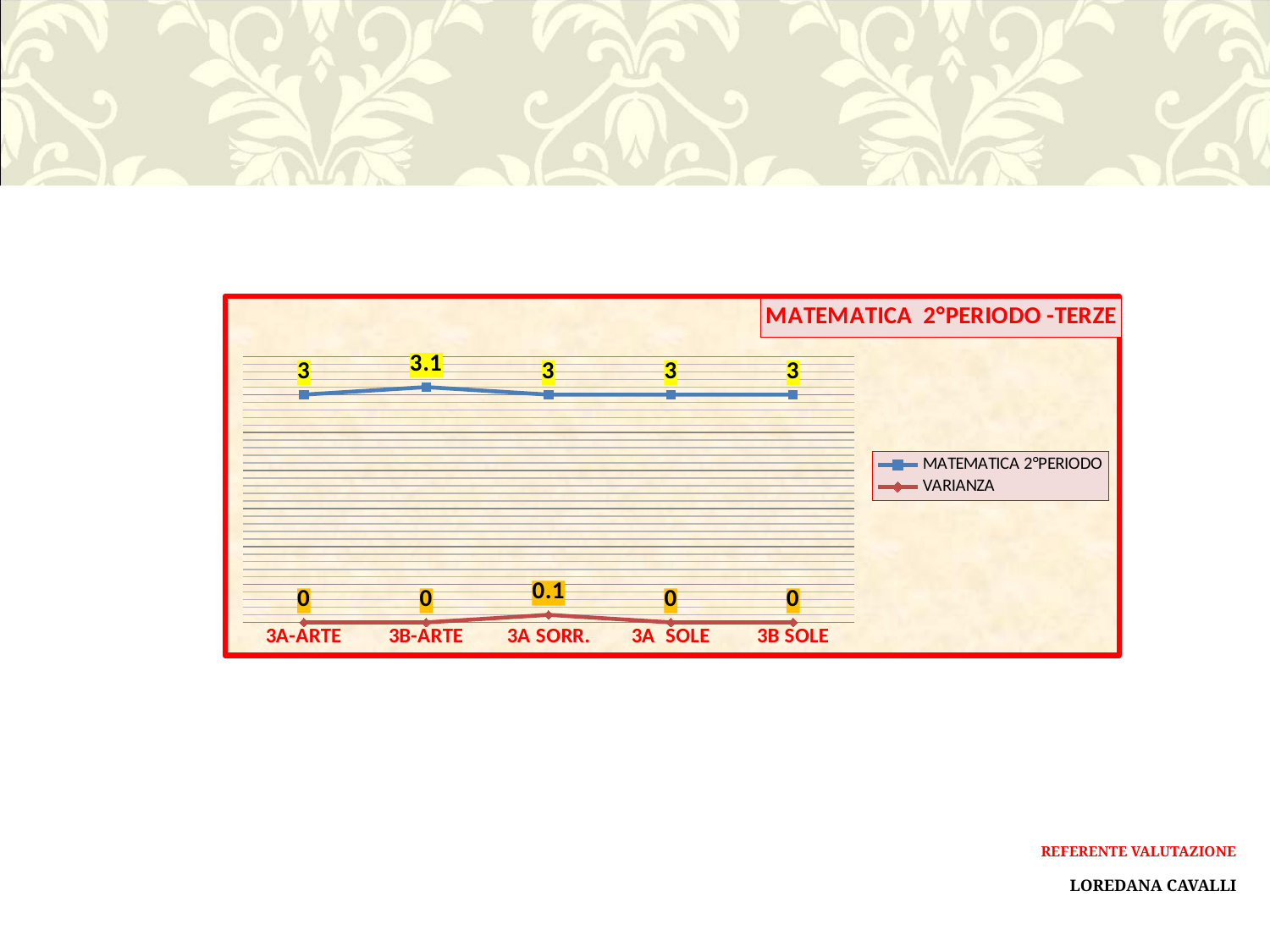
What is the VARIANZA value for 3B SOLE? 0 Which category has the highest VARIANZA value? 3A SORR. How many categories are shown on the x axis? 5 What is the MATEMATICA 2°PERIODO value for 3B-ARTE? 3.1 What kind of chart is shown? Line chart Which category has the highest MATEMATICA 2°PERIODO value? 3B-ARTE What is the VARIANZA value for 3A SORR.? 0.1 What is the title of the chart? MATEMATICA 2°PERIODO -TERZE How many series does the legend list? 2 Which is larger, the MATEMATICA 2°PERIODO value for 3B-ARTE or for 3A SORR.? 3B-ARTE What is the MATEMATICA 2°PERIODO value for 3A SOLE? 3 What is the difference between the MATEMATICA 2°PERIODO values for 3B-ARTE and 3A-ARTE? 0.1